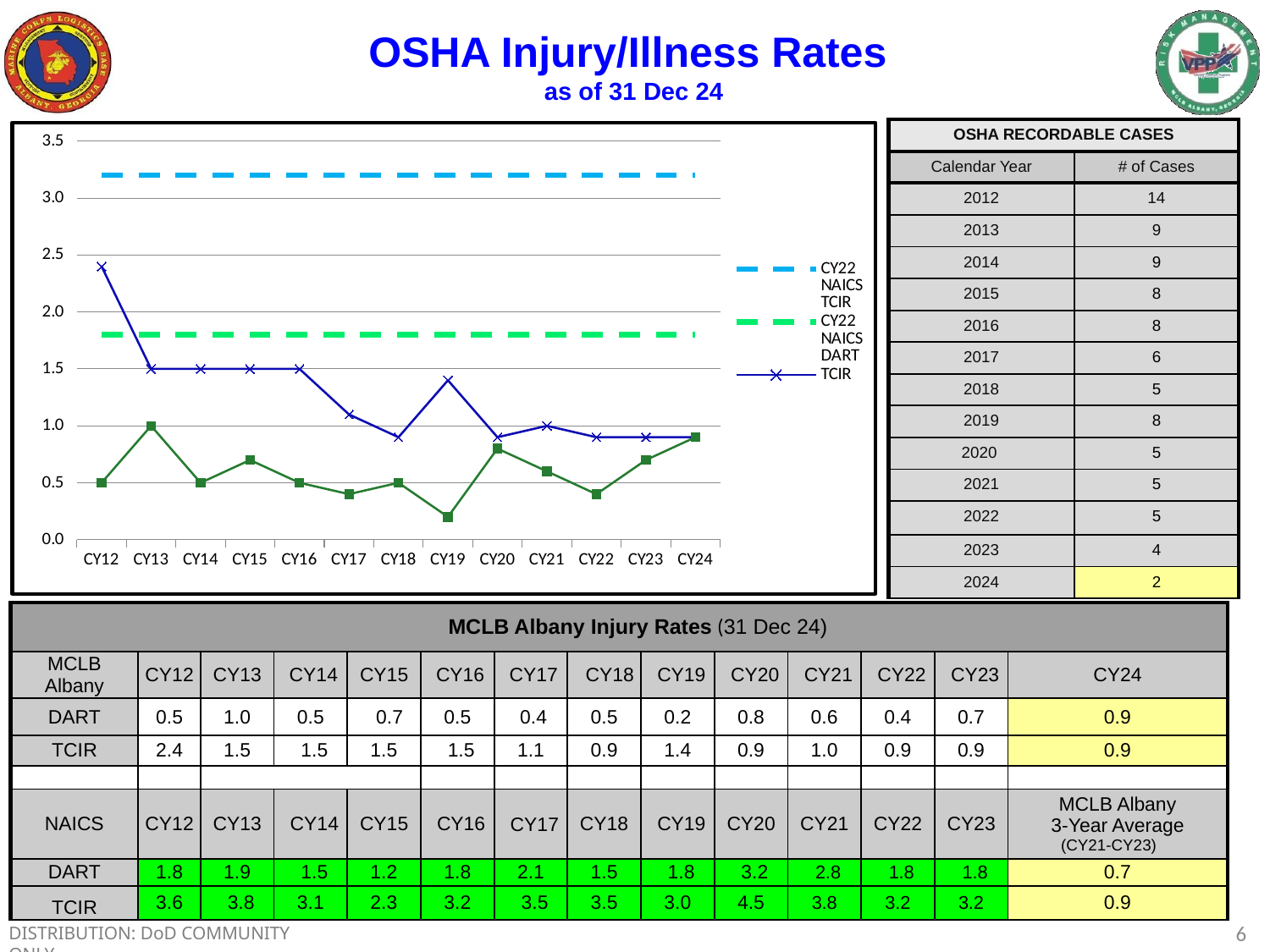
What is the first category on the chart's x axis? CY12 What kind of chart is shown on the slide? line chart What is the difference between the TCIR value for CY12 and for CY24? 1.5 Is the TCIR value for CY12 greater or less than 2.0? greater What is the TCIR value for CY12? 2.4 In which year is the TCIR line at its highest? CY12 How many entries does the chart legend list? 3 What is the TCIR value for CY24? 0.9 How many calendar-year categories are shown on the chart's x axis? 13 Which is larger, the TCIR value for CY12 or for CY24? CY12 Does the TCIR line generally rise or fall from CY12 to CY24? fall Is the CY22 NAICS TCIR dashed line greater or less than 3.0? greater